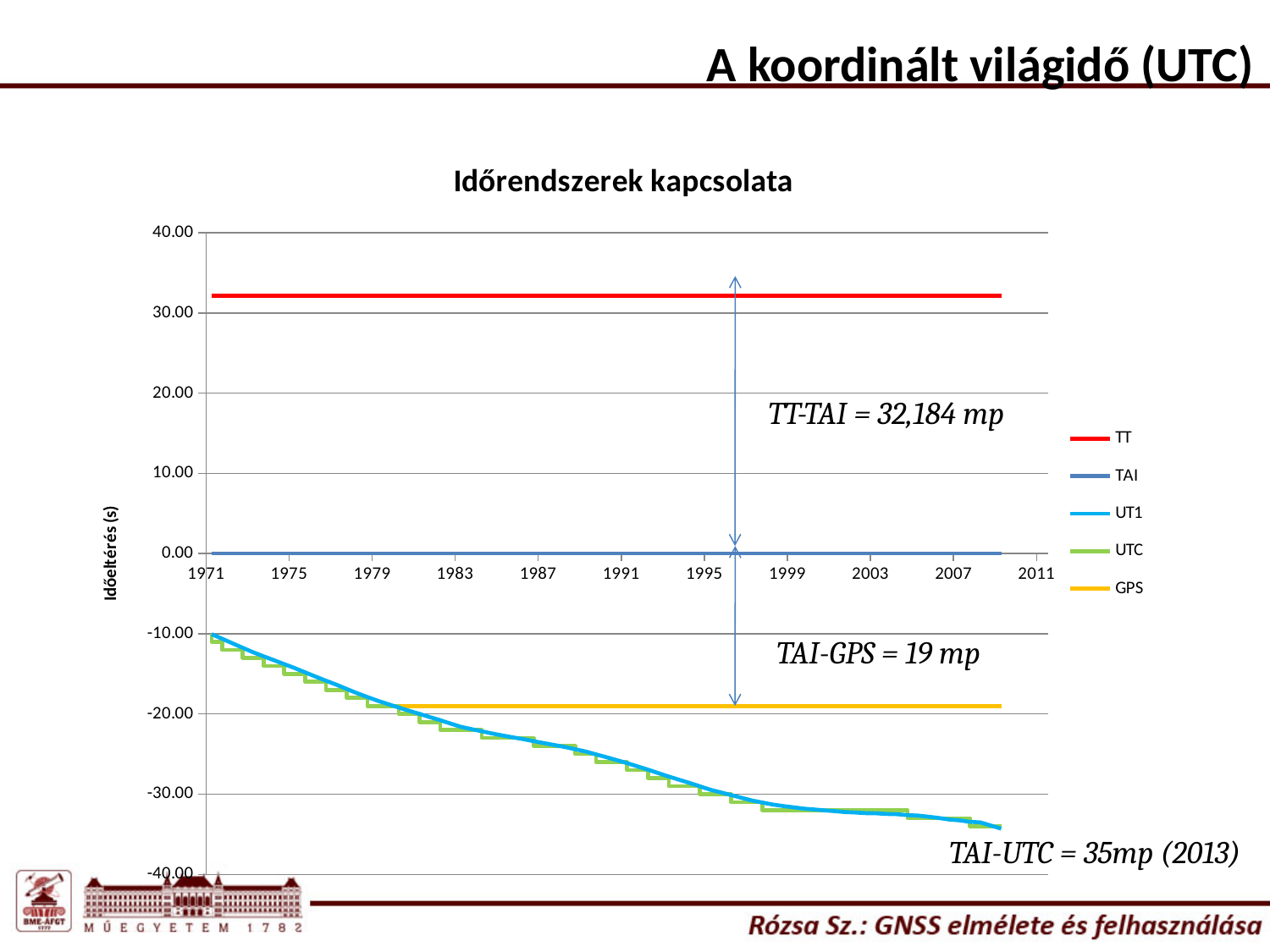
Does the UTC series rise or fall from 1971 to 2011? fall According to the annotation on the chart, what is TAI-GPS? 19 mp What value does the TAI series lie on throughout the chart? 0.00 How many series does the chart legend list? 5 According to the annotation on the chart, what is TT-TAI? 32,184 mp Which series has the highest values on the chart? TT What is the title of the chart? Időrendszerek kapcsolata Which series has larger values, TT or GPS? TT Is the value of the TT series greater or less than 30.00? greater Is the UTC value in 1971 greater or less than -20.00? greater What kind of chart is shown on the slide? line chart Is the value of the GPS series greater or less than -10.00? less